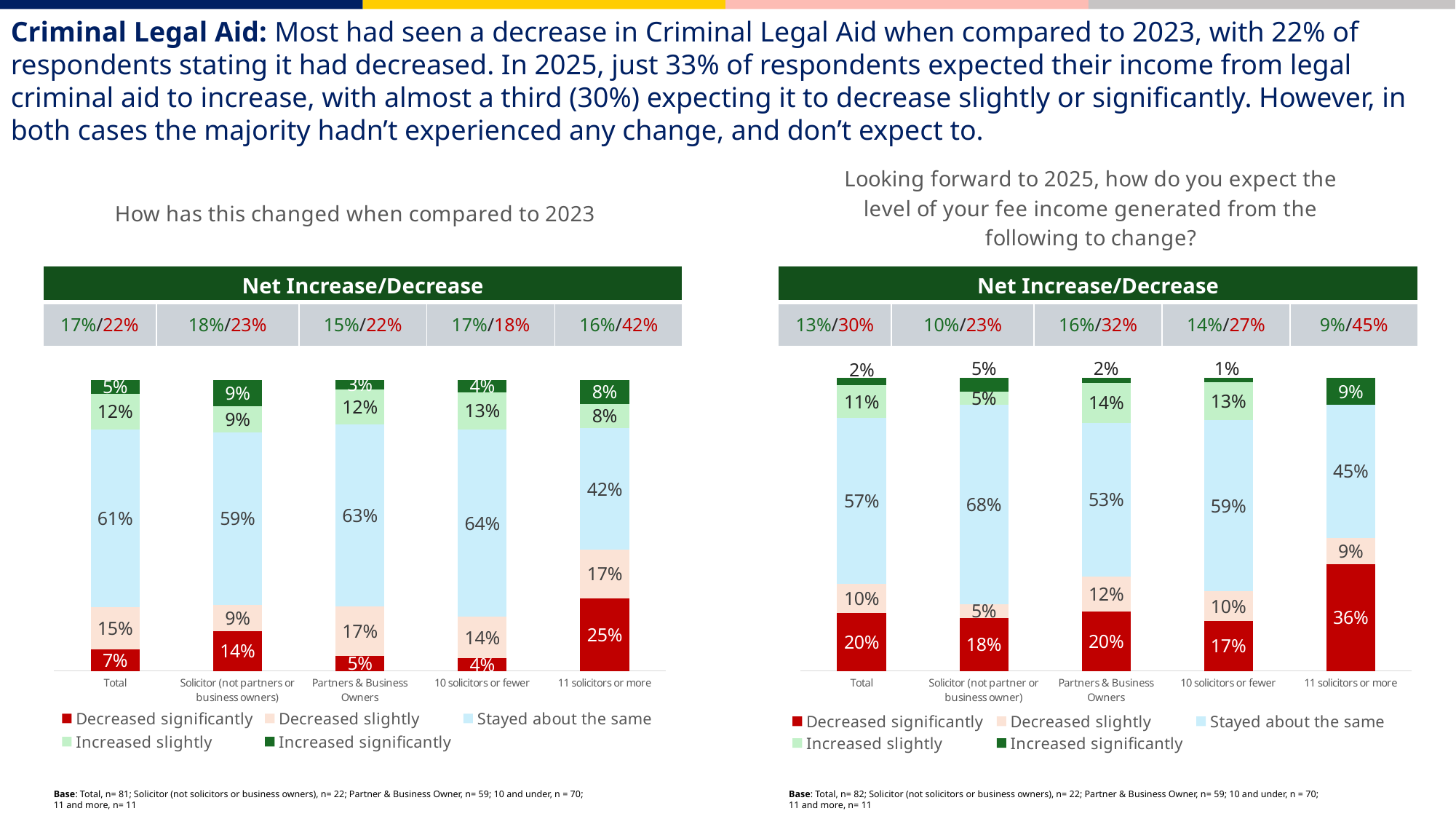
In the right chart (Looking forward to 2025), which category has the highest 'Decreased significantly' value? 11 solicitors or more In the right chart (Looking forward to 2025), what percentage of the 'Solicitor (not partner or business owner)' group expect income to stay about the same? 68% In the left chart (How has this changed when compared to 2023), what is the difference between the 'Decreased slightly' values for Partners & Business Owners and Total? 2% In the left chart (How has this changed when compared to 2023), which category has the highest 'Decreased significantly' value? 11 solicitors or more In the left chart (How has this changed when compared to 2023), what percentage of the Total group said Criminal Legal Aid stayed about the same? 61% How many series does the legend of the left chart (How has this changed when compared to 2023) list? 5 What type of chart is the right chart (Looking forward to 2025)? Stacked bar chart In the right chart (Looking forward to 2025), what is the net increase/decrease shown for '11 solicitors or more'? 9%/45% In the right chart (Looking forward to 2025), what percentage of the Total group expect their fee income to decrease significantly? 20% In the left chart (How has this changed when compared to 2023), what percentage of the '11 solicitors or more' group reported a significant decrease? 25% In the left chart (How has this changed when compared to 2023), which category has the lowest 'Stayed about the same' value? 11 solicitors or more In the right chart (Looking forward to 2025), which is larger: the 'Increased slightly' value for Partners & Business Owners or for '10 solicitors or fewer'? Partners & Business Owners